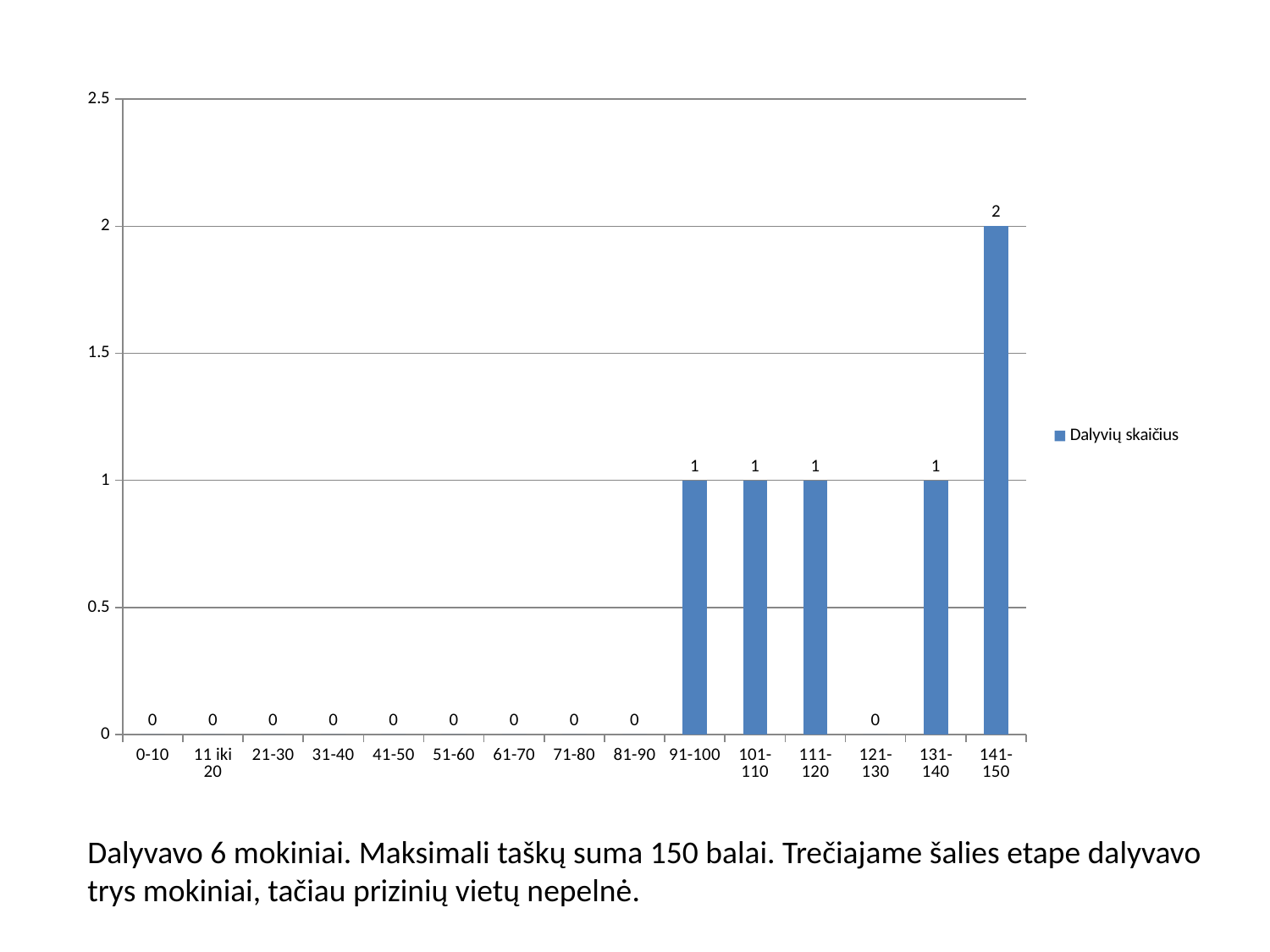
What is the difference between the values for 141-150 and 111-120? 1 What is the value for the 91-100 category? 1 What is the name of the series shown in the legend? Dalyvių skaičius Is the value for 141-150 greater or less than 1.5? greater Which is larger, the value for 141-150 or the value for 101-110? 141-150 What kind of chart is shown on the slide? bar chart What is the value for the 121-130 category? 0 How many categories are shown on the x axis? 15 What is the value for the 141-150 category? 2 How many series does the legend list? 1 Which category has the highest value? 141-150 What is the value for the 131-140 category? 1